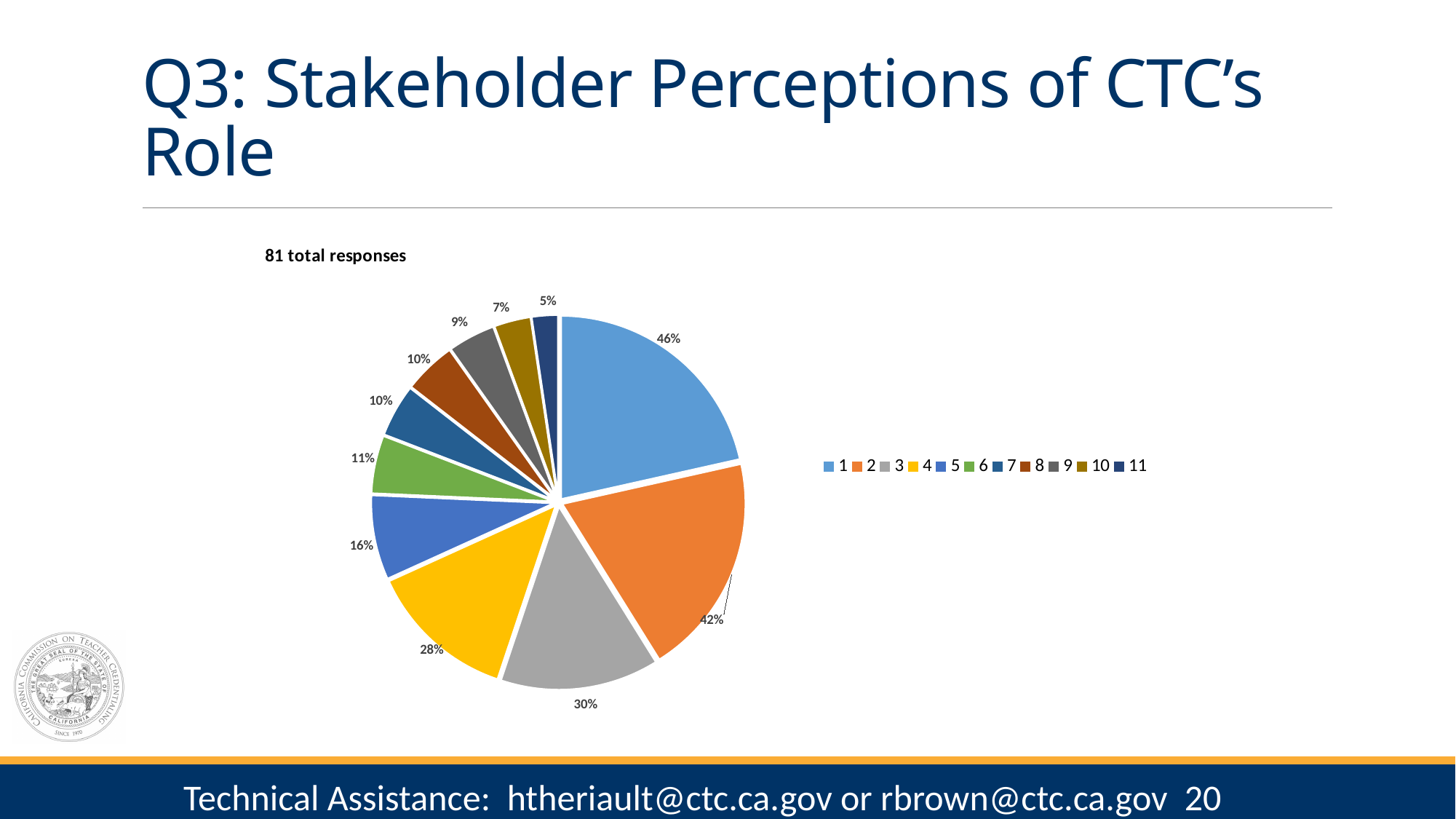
What percentage is shown for category 3 in the pie chart? 30% What colour is the slice for category 4 in the pie chart? yellow What kind of chart is shown on the slide? pie chart Which is larger, the slice for category 6 or the slice for category 9? 6 What is the difference in percentage points between category 2 and category 4? 14 What percentage is shown for category 10 in the pie chart? 7% Which category has the largest slice in the pie chart? 1 What percentage is shown for category 5 in the pie chart? 16% What percentage is shown for category 1 in the pie chart? 46% Which category has the smallest slice in the pie chart? 11 How many categories does the legend list? 11 How many total responses does the chart label state? 81